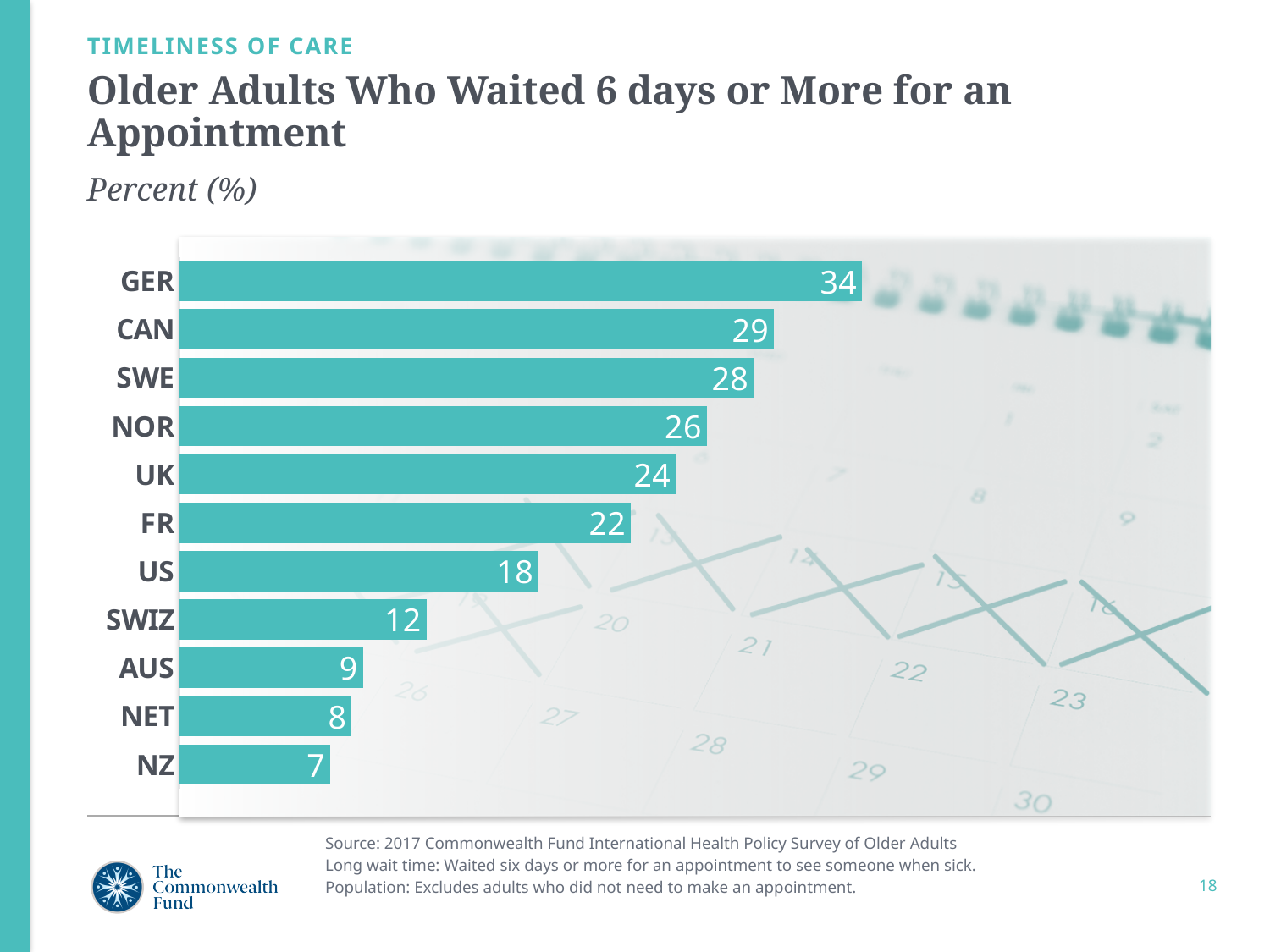
What kind of chart is shown on the slide? bar chart Which is larger, the value for AUS or the value for NOR? NOR What is the value for SWIZ? 12 What is the value for GER? 34 How many countries are shown in the chart? 11 Which country has the highest value? GER Which country has the lowest value? NZ What is the difference between the values for GER and CAN? 5 Which is larger, the value for SWE or the value for FR? SWE What is the value for US? 18 What is the difference between the values for UK and NET? 16 What is the title of the chart? Older Adults Who Waited 6 days or More for an Appointment